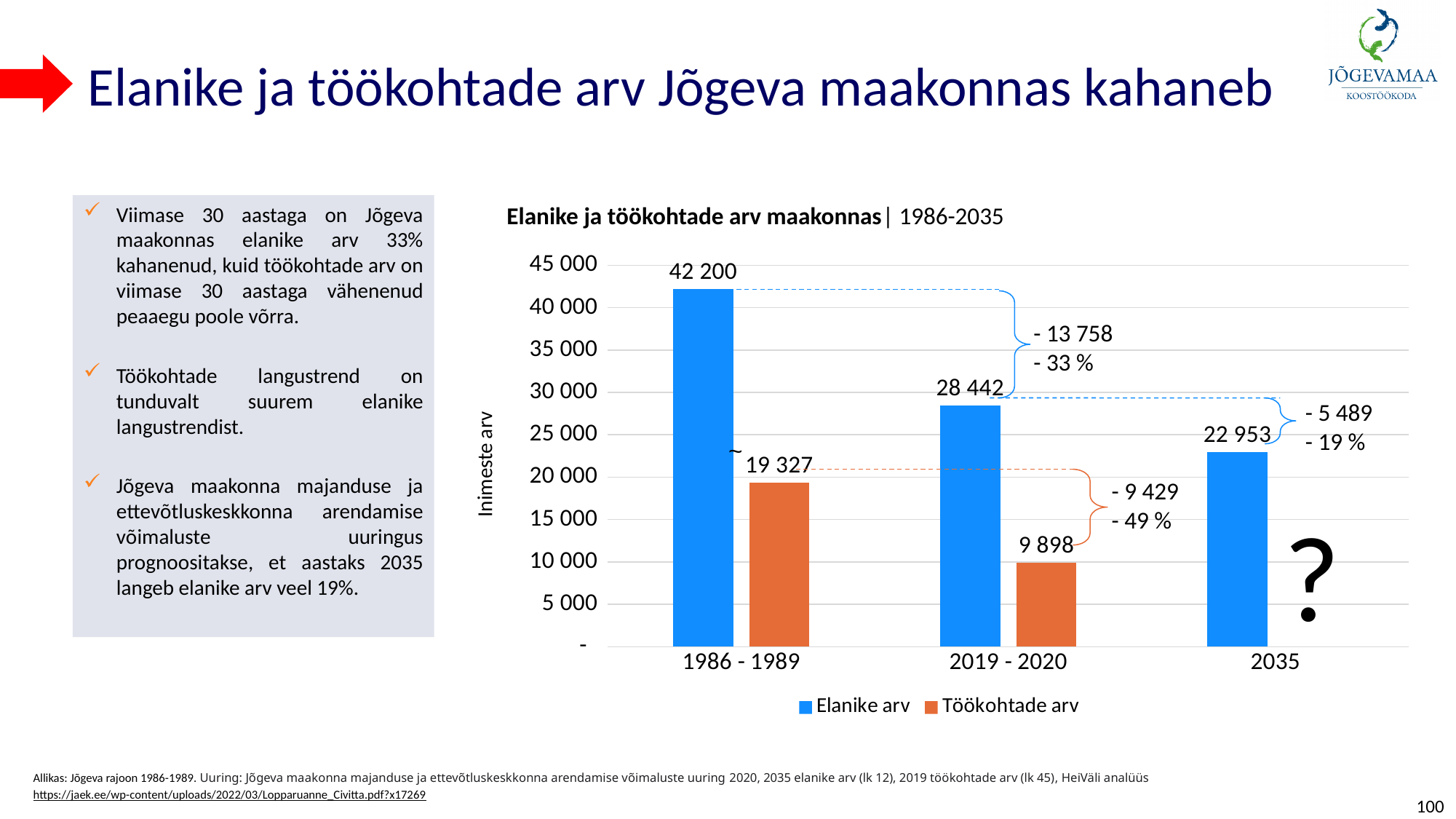
What is the difference between Elanike arv in 2019 - 2020 and in 2035? 5 489 What is the value of Töökohtade arv for 2019 - 2020? 9 898 Which period has the highest value of Elanike arv? 1986 - 1989 How many series does the legend list? 2 Is the value of Töökohtade arv for 1986 - 1989 greater or less than 20 000? less What is the value of Elanike arv for 2019 - 2020? 28 442 What kind of chart is shown on the slide? Bar chart Which period has the lowest value of Elanike arv? 2035 What is the difference between Elanike arv in 1986 - 1989 and in 2019 - 2020? 13 758 What is the projected value of Elanike arv for 2035? 22 953 What is the value of Elanike arv for 1986 - 1989? 42 200 Which is larger in 2019 - 2020: Elanike arv or Töökohtade arv? Elanike arv